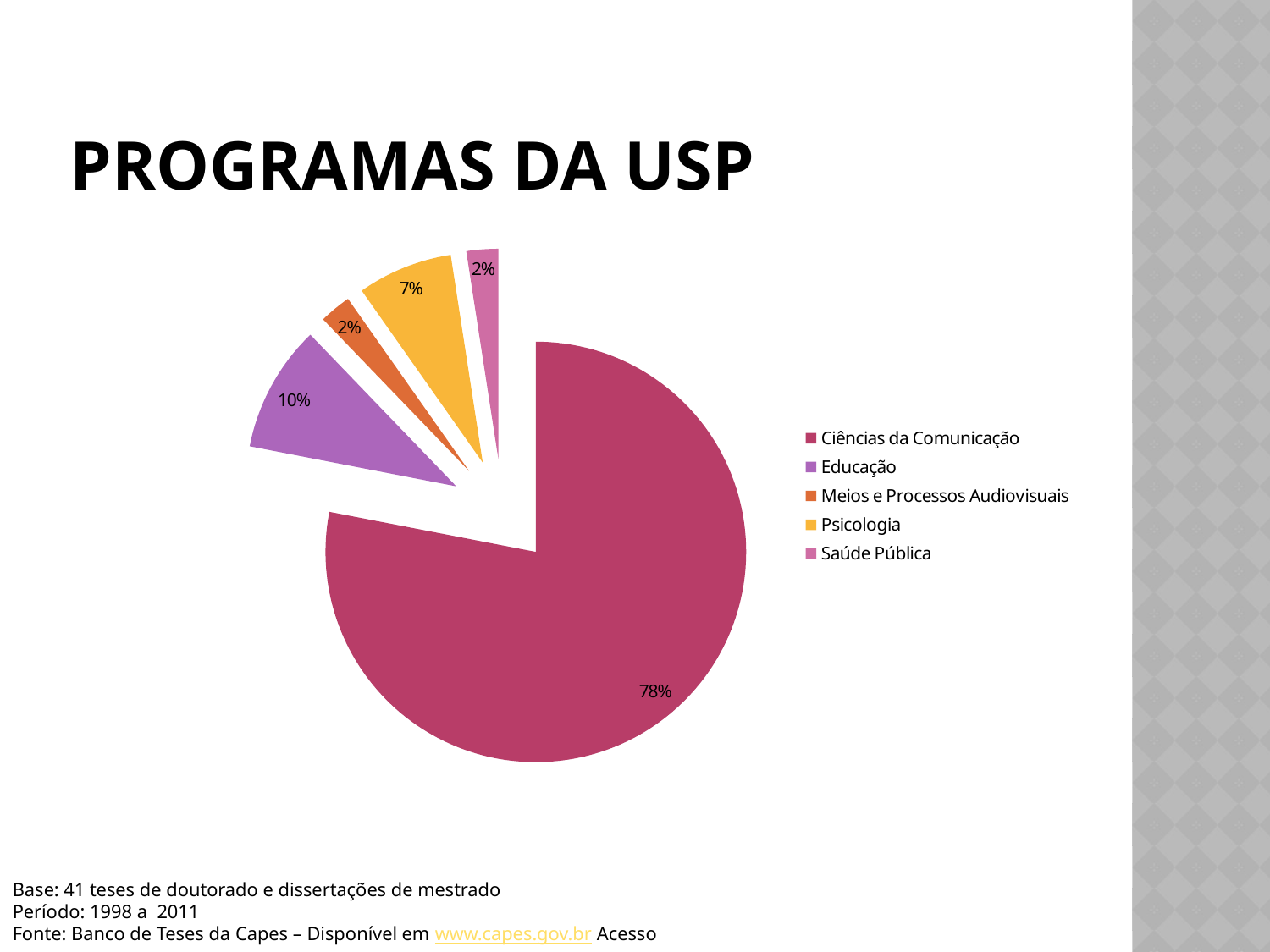
What share of the pie does Ciências da Comunicação hold? 78% What share of the pie does Educação hold? 10% What kind of chart is shown on the slide? pie chart What share of the pie does Psicologia hold? 7% What is the difference in percentage points between Psicologia and Saúde Pública? 5 Which is larger, the slice for Educação or the slice for Psicologia? Educação What is the difference in percentage points between Ciências da Comunicação and Educação? 68 How many categories does the pie chart show? 5 Which category has the largest slice of the pie? Ciências da Comunicação What is the title of the slide containing the pie chart? PROGRAMAS DA USP